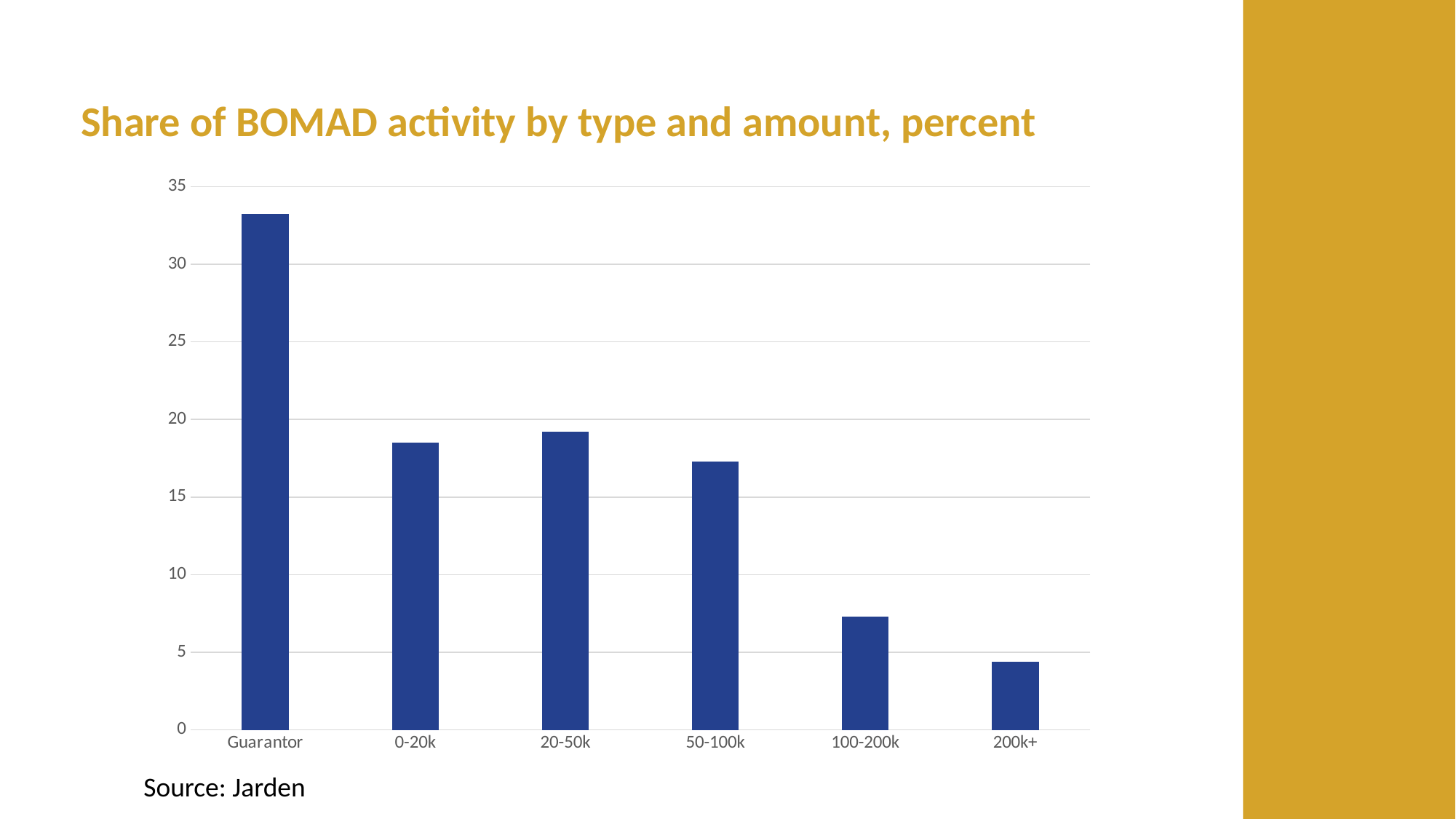
Is the value for 50-100k greater or less than 15? greater Is the value for 200k+ greater or less than 5? less Is the value for 0-20k greater or less than 20? less How many categories are shown on the x axis of the chart? 6 Which category has the lowest value in the chart? 200k+ What is the title of the chart? Share of BOMAD activity by type and amount, percent Which is larger, the value for 20-50k or the value for 50-100k? 20-50k Which is larger, the value for 100-200k or the value for 200k+? 100-200k What kind of chart is shown on the slide? bar chart Which category has the highest value in the chart? Guarantor